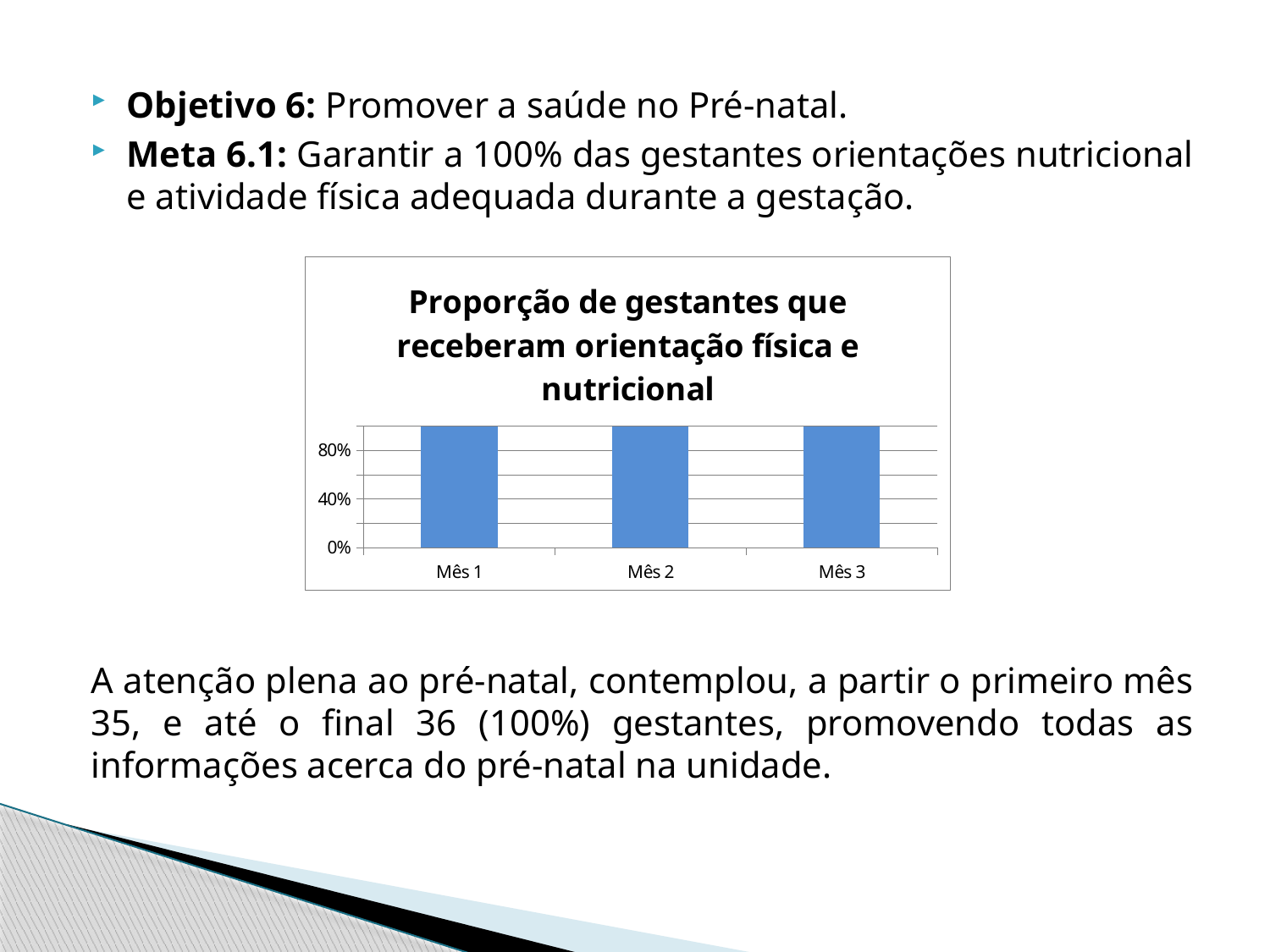
What kind of chart is shown on the slide? bar chart Is the value for Mês 2 greater or less than 80%? greater Do the bar values rise, fall, or stay level from Mês 1 to Mês 3? stay level How many categories (months) are shown on the x axis of the chart? 3 Is the value for Mês 3 greater or less than 40%? greater Is the value for Mês 1 greater or less than 80%? greater What is the label of the first category on the x axis? Mês 1 What is the title of the chart? Proporção de gestantes que receberam orientação física e nutricional